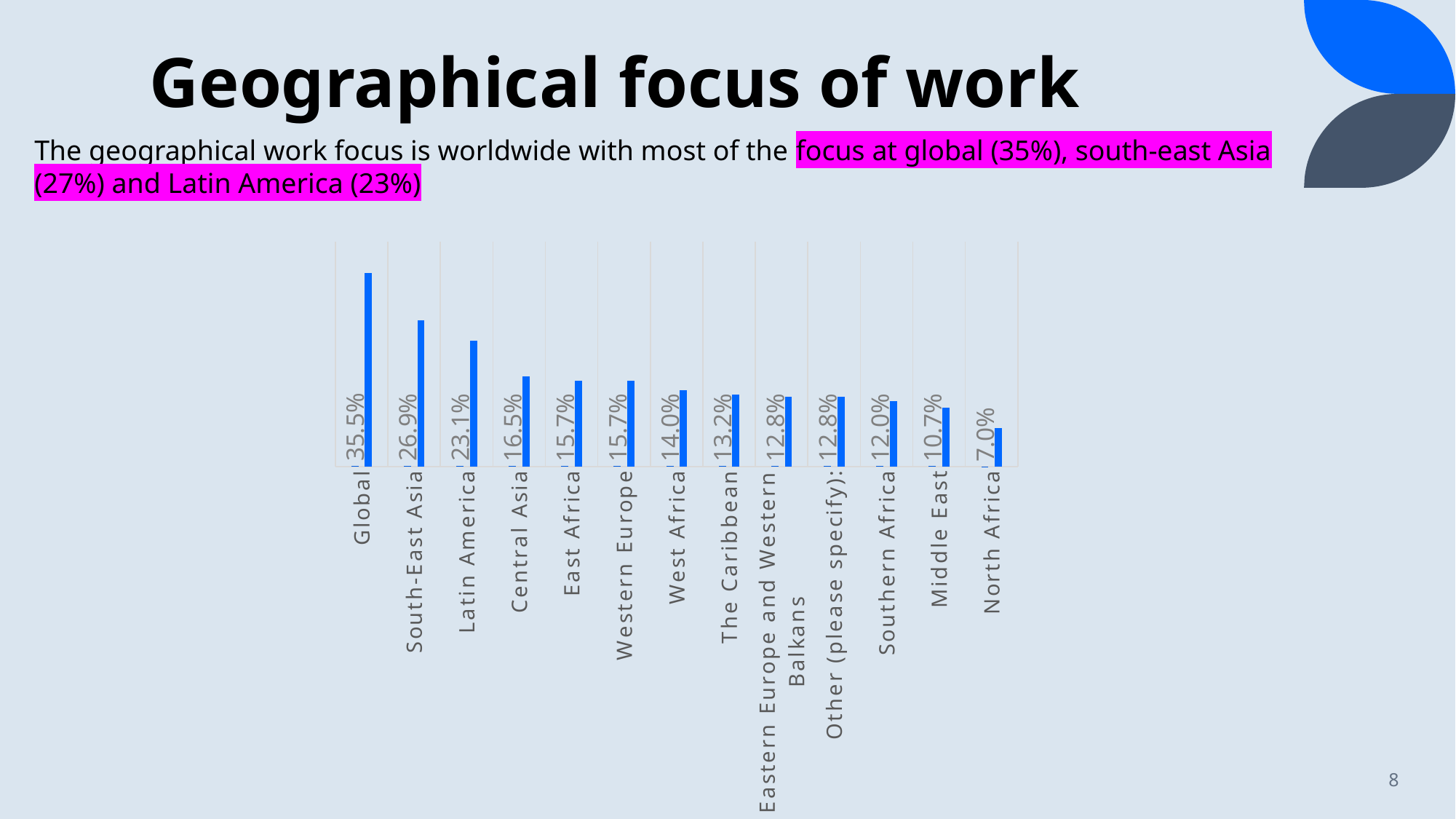
What is the difference between the values for Central Asia and North Africa? 9.5% Which is larger, the value for West Africa or the value for Southern Africa? West Africa What kind of chart is shown on the slide? Bar chart Which category has the highest value? Global What is the value for Eastern Europe and Western Balkans? 12.8% What is the value for Global? 35.5% What is the value for Latin America? 23.1% Which category has the lowest value? North Africa What is the value for South-East Asia? 26.9% What is the difference between the values for Global and South-East Asia? 8.6% What is the value for Middle East? 10.7% How many categories are shown in the chart? 13